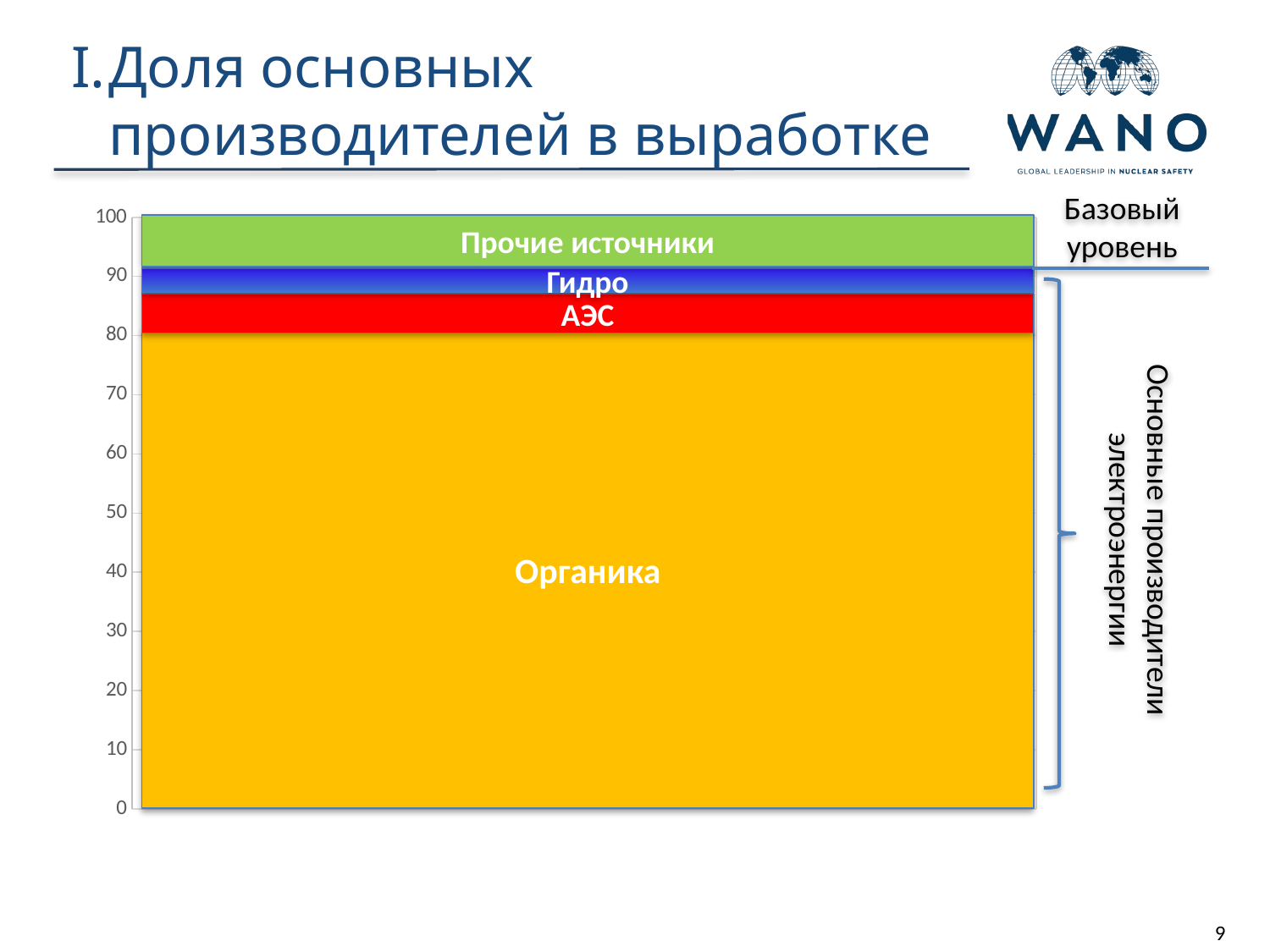
Which segment of the stacked bar is the smallest? Гидро What is the total height of the stacked bar on the y axis? 100 Is the value for Органика greater or less than 90? less Is the value for Органика greater or less than 70? greater What kind of chart is shown on the slide? Stacked bar chart How many segments make up the stacked bar? 4 Which segment is at the top of the stacked bar? Прочие источники What is the highest value shown on the y axis? 100 Which is larger, the Органика segment or the АЭС segment? Органика Which segment of the stacked bar is the largest? Органика Which is larger, the Прочие источники segment or the Гидро segment? Прочие источники